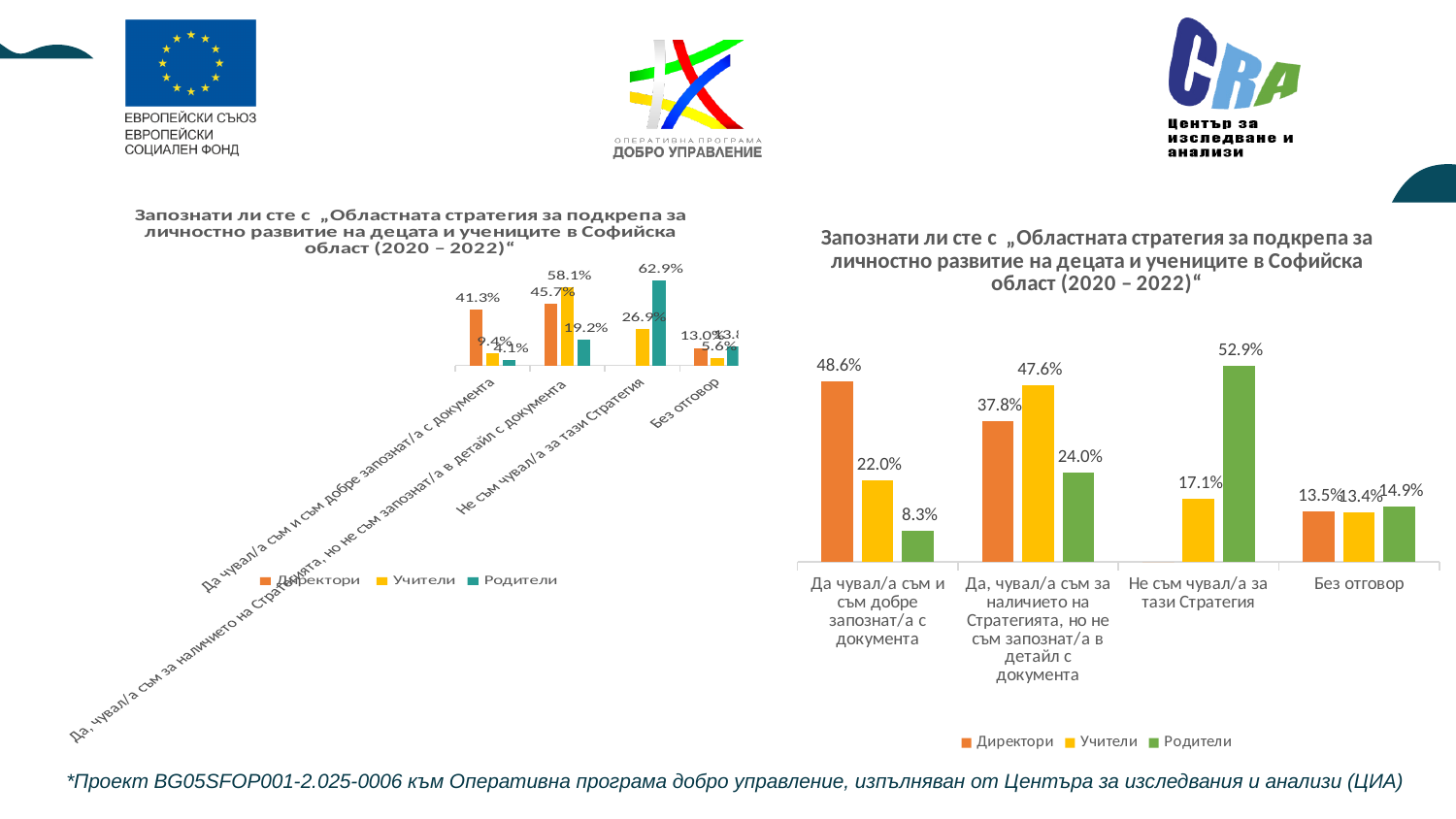
In the right-hand chart, what is the value for Учители in the category "Да, чувал/а съм за наличието на Стратегията, но не съм запознат/а в детайл с документа"? 47.6% In the left-hand chart, what is the value for Родители in the category "Да, чувал/а съм за наличието на Стратегията, но не съм запознат/а в детайл с документа"? 19.2% In the left-hand chart, what is the value for Директори in the category "Да чувал/а съм и съм добре запознат/а с документа"? 41.3% What type of chart is the right-hand chart? Bar chart In the right-hand chart, which is larger: the Родители value for "Не съм чувал/а за тази Стратегия" or the Директори value for "Да чувал/а съм и съм добре запознат/а с документа"? Родители value for "Не съм чувал/а за тази Стратегия" In the right-hand chart, which group has the highest value in the category "Не съм чувал/а за тази Стратегия"? Родители In the right-hand chart, which group has the lowest value in the category "Да чувал/а съм и съм добре запознат/а с документа"? Родители How many categories are shown on the x axis of the right-hand chart? 4 In the right-hand chart, what is the difference between the Директори and Учители values in the category "Да чувал/а съм и съм добре запознат/а с документа"? 26.6% In the right-hand chart, what is the value for Родители in the category "Не съм чувал/а за тази Стратегия"? 52.9% In the right-hand chart, what is the value for Директори in the category "Да чувал/а съм и съм добре запознат/а с документа"? 48.6% How many series does the legend of the right-hand chart list? 3